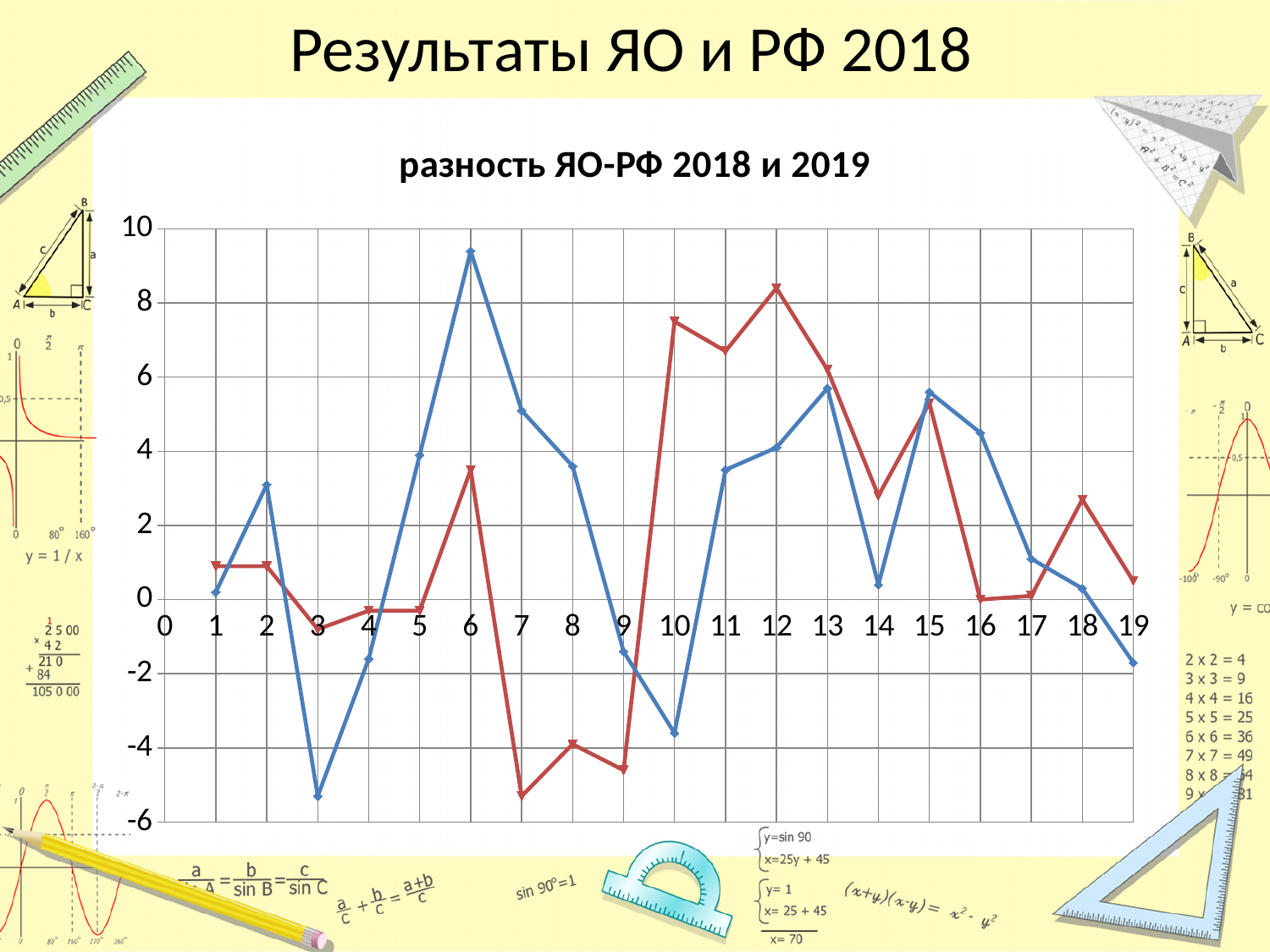
How many data points does the blue line have? 19 What colours are the two lines plotted on the chart? blue and red Is the value of the blue line at x = 6 greater or less than 8? greater Is the value of the red line at x = 10 greater or less than 6? greater At which x-axis value does the blue line reach its highest point? 6 At which x-axis value does the red line reach its highest point? 12 What is the title of the chart? разность ЯО-РФ 2018 и 2019 At which x-axis value does the red line reach its lowest point? 7 What kind of chart is shown on the slide? line chart At x = 10, which line has the higher value, the blue line or the red line? red line Is the value of the blue line at x = 3 greater or less than -4? less At which x-axis value does the blue line reach its lowest point? 3